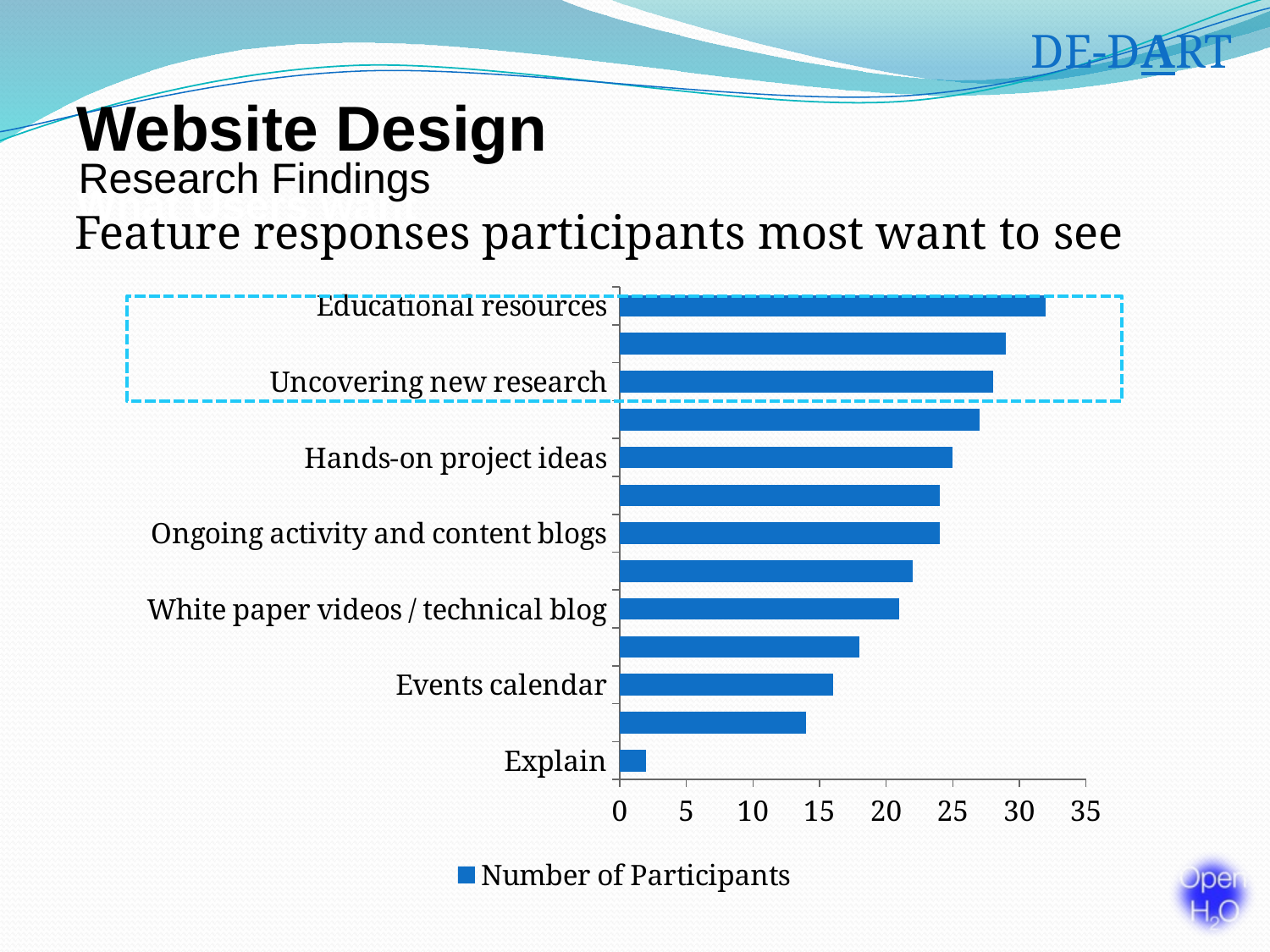
Which category has the longest bar in the chart? Educational resources What is the legend entry for the series in the chart? Number of Participants Which has a larger value, Hands-on project ideas or White paper videos / technical blog? Hands-on project ideas How many series does the legend list? 1 Which category has the shortest bar in the chart? Explain Is the value for Events calendar greater or less than 20? less How many bars are plotted in the chart? 13 Is the value for Uncovering new research greater or less than 25? greater Is the value for White paper videos / technical blog greater or less than 25? less What kind of chart is shown on the slide? Bar chart